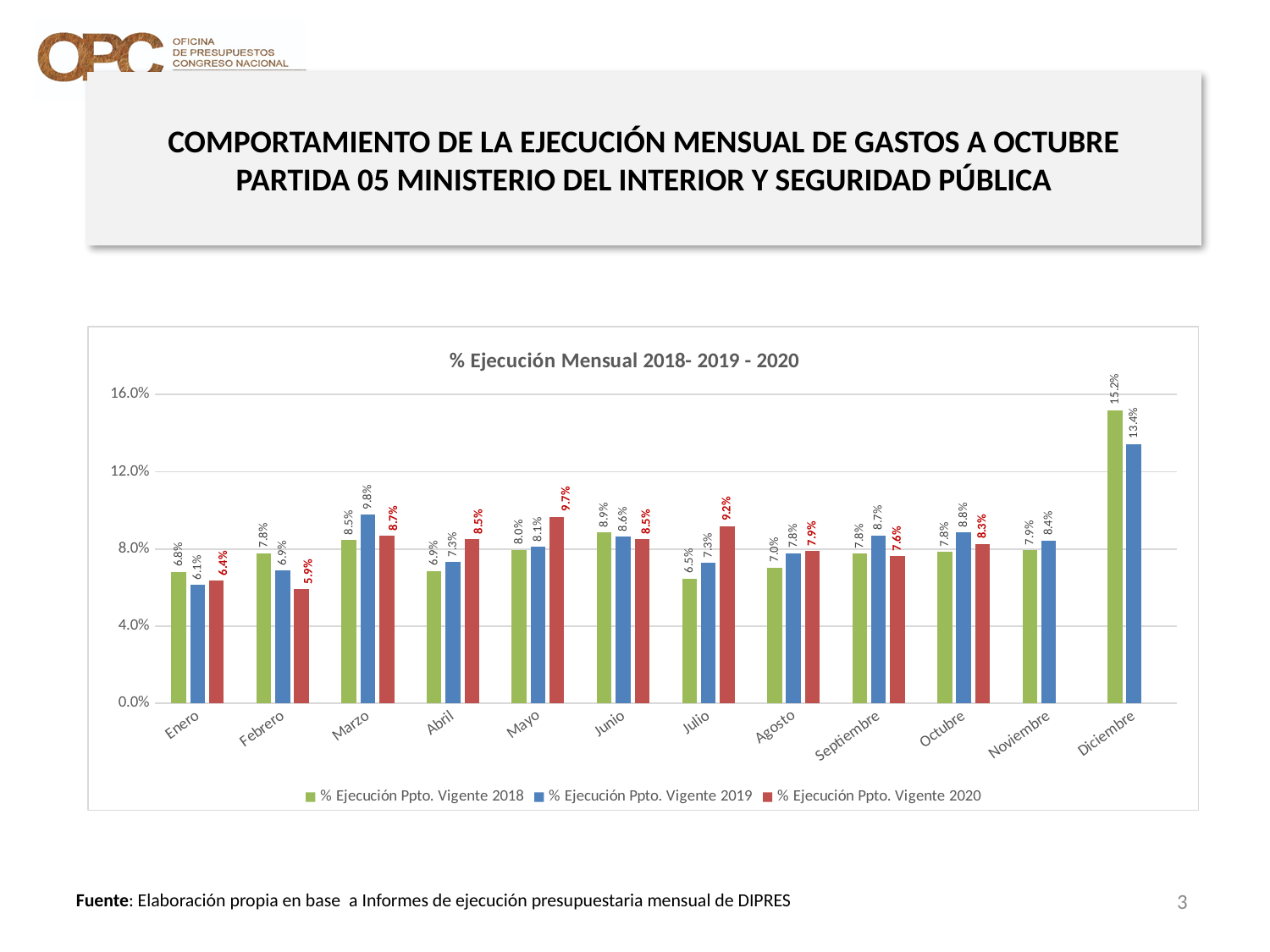
Is the value for % Ejecución Ppto. Vigente 2018 in Diciembre greater or less than 12.0%? greater Which is larger in Marzo: the 2018 value or the 2019 value? 2019 What is the value for % Ejecución Ppto. Vigente 2019 in Julio? 7.3% Which month has the highest value for % Ejecución Ppto. Vigente 2019? Diciembre Which month has the highest value for % Ejecución Ppto. Vigente 2020? Mayo How many months are shown on the x axis? 12 How many series does the legend list? 3 What is the value for % Ejecución Ppto. Vigente 2020 in Marzo? 8.7% What kind of chart is shown? Bar chart Which month has the lowest value for % Ejecución Ppto. Vigente 2020? Febrero What is the difference between the 2018 and 2019 values in Diciembre? 1.8% What is the value for % Ejecución Ppto. Vigente 2018 in Diciembre? 15.2%